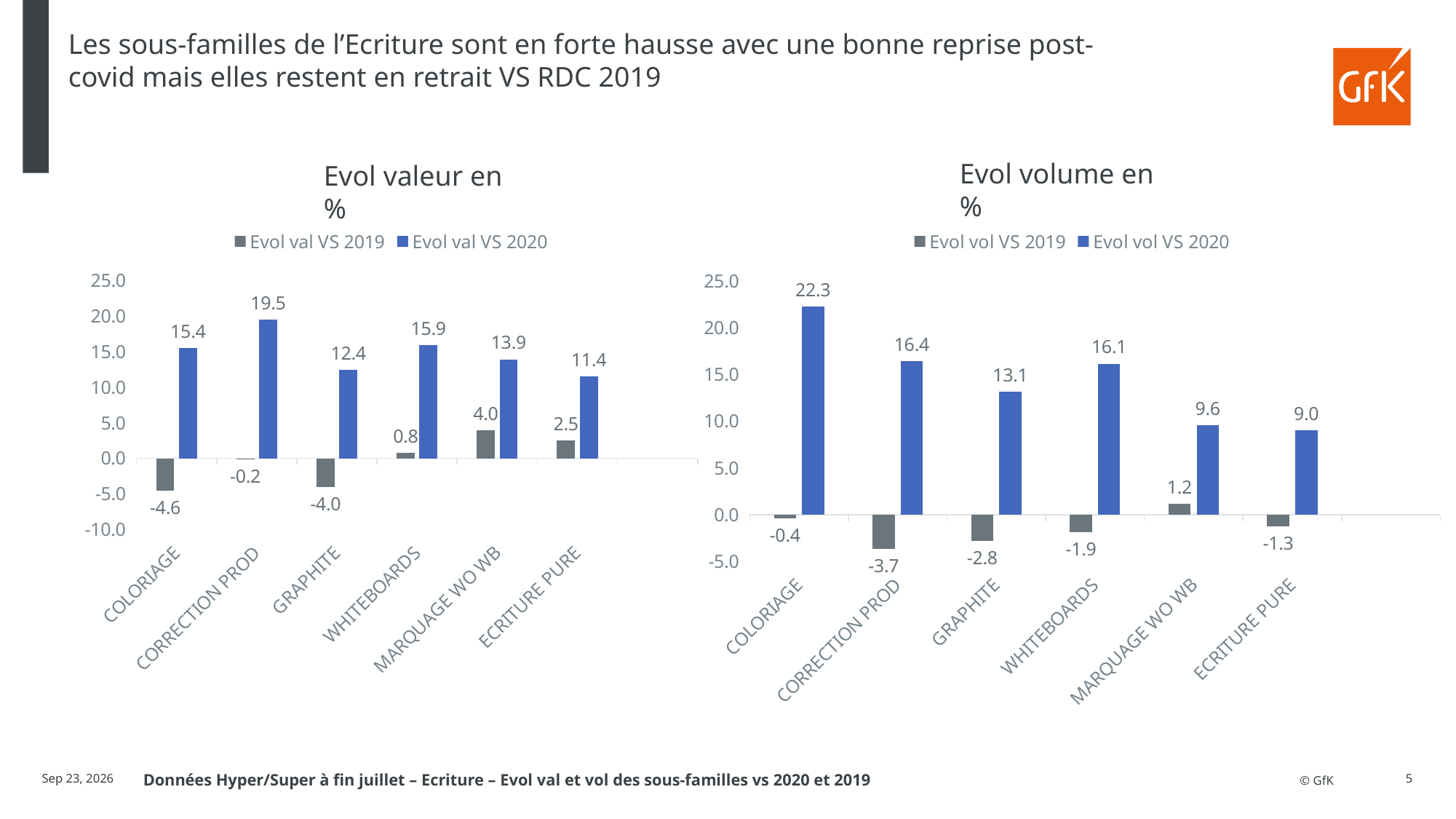
How many series does the legend of the 'Evol valeur en %' chart list? 2 In the 'Evol valeur en %' chart, what is the difference between the Evol val VS 2020 values for WHITEBOARDS and GRAPHITE? 3.5 In the 'Evol volume en %' chart, what is the Evol vol VS 2019 value for CORRECTION PROD? -3.7 In the 'Evol volume en %' chart, what colour are the Evol vol VS 2020 bars? Blue In the 'Evol valeur en %' chart, what is the Evol val VS 2020 value for CORRECTION PROD? 19.5 In the 'Evol volume en %' chart, what is the Evol vol VS 2020 value for COLORIAGE? 22.3 How many categories are shown on the x axis of the 'Evol volume en %' chart? 6 In the 'Evol volume en %' chart, which category has the lowest Evol vol VS 2020 value? ECRITURE PURE In the 'Evol valeur en %' chart, what is the Evol val VS 2019 value for COLORIAGE? -4.6 What kind of chart is the 'Evol valeur en %' chart? Bar chart In the 'Evol valeur en %' chart, which category has the highest Evol val VS 2020 value? CORRECTION PROD In the 'Evol volume en %' chart, which is larger for MARQUAGE WO WB: Evol vol VS 2019 or Evol vol VS 2020? Evol vol VS 2020